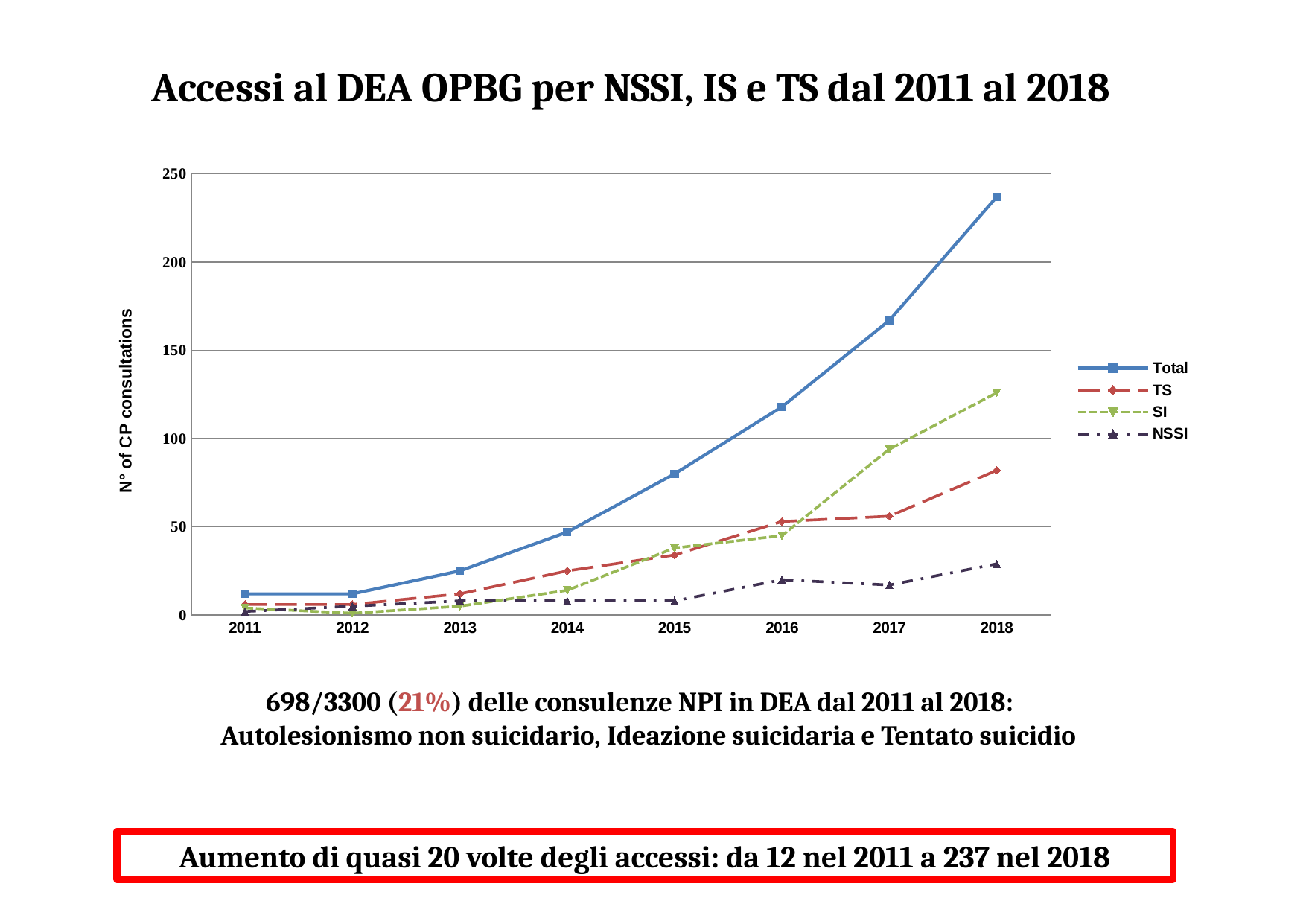
In 2018, which is larger, SI or TS? SI What is the Total value for 2011? 12 Does the Total series rise or fall from 2011 to 2018? rise Which series has the lowest value in 2018? NSSI By how much did the Total increase from 2011 to 2018? 225 Is the Total value for 2016 greater or less than 100? greater How many years are plotted along the x axis? 8 How many series does the legend list? 4 What is the Total value for 2018? 237 What kind of chart is shown on the slide? line chart Which series has the highest value in 2018? Total Is the TS value for 2018 greater or less than 100? less